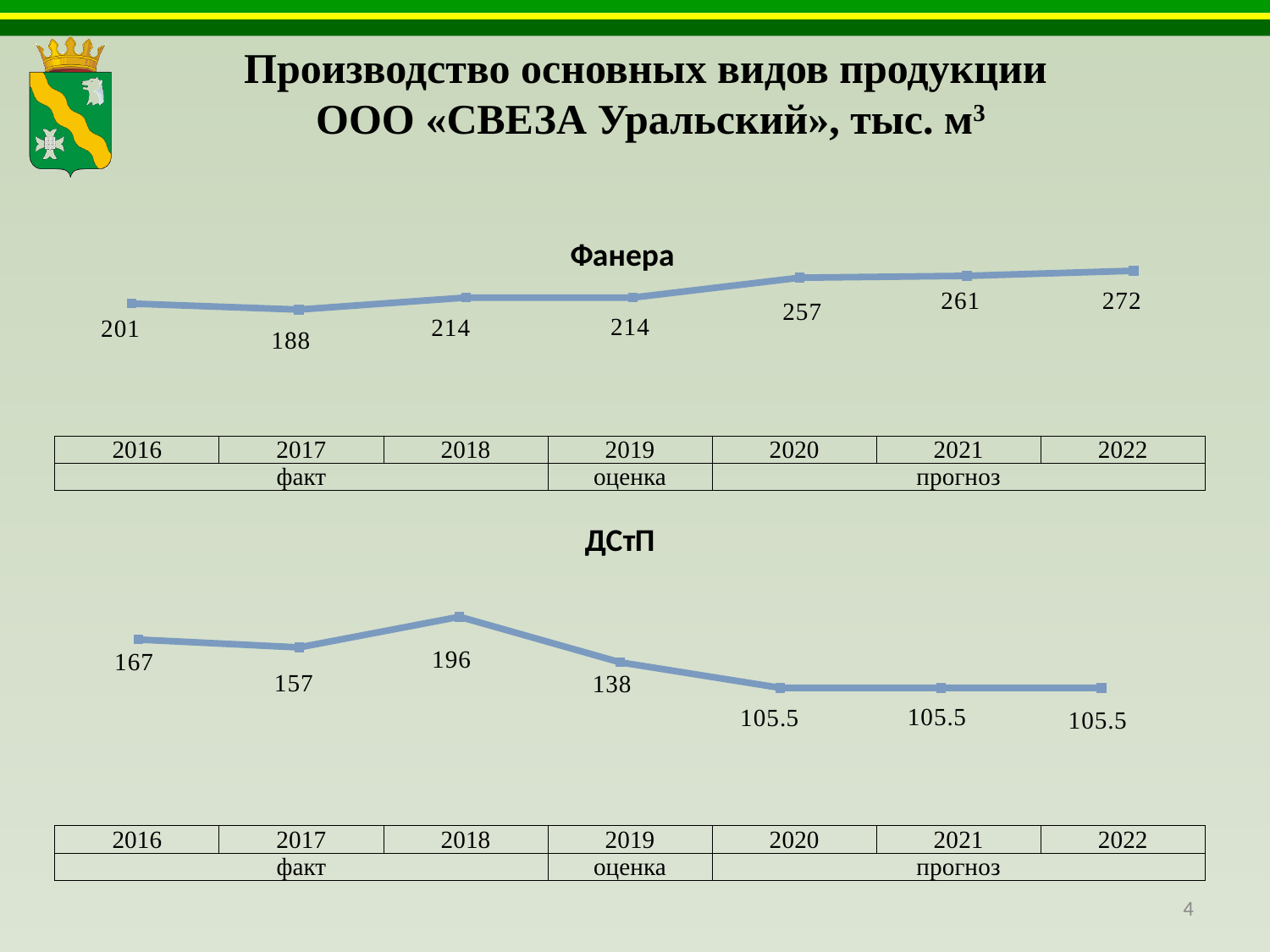
In the Фанера chart, what is the value for 2016? 201 In the Фанера chart, which year has the lowest value? 2017 In the ДСтП chart, what is the value for 2018? 196 In the ДСтП chart, what is the difference between the values for 2018 and 2019? 58 In the Фанера chart, what is the value for 2022? 272 How many data points does the ДСтП chart show? 7 In the Фанера chart, which year has the highest value? 2022 What type of chart is the Фанера chart? Line chart In the ДСтП chart, which is larger, the value for 2016 or the value for 2019? 2016 In the ДСтП chart, which year has the highest value? 2018 In the Фанера chart, what is the difference between the values for 2020 and 2019? 43 In the ДСтП chart, what is the value for 2021? 105.5